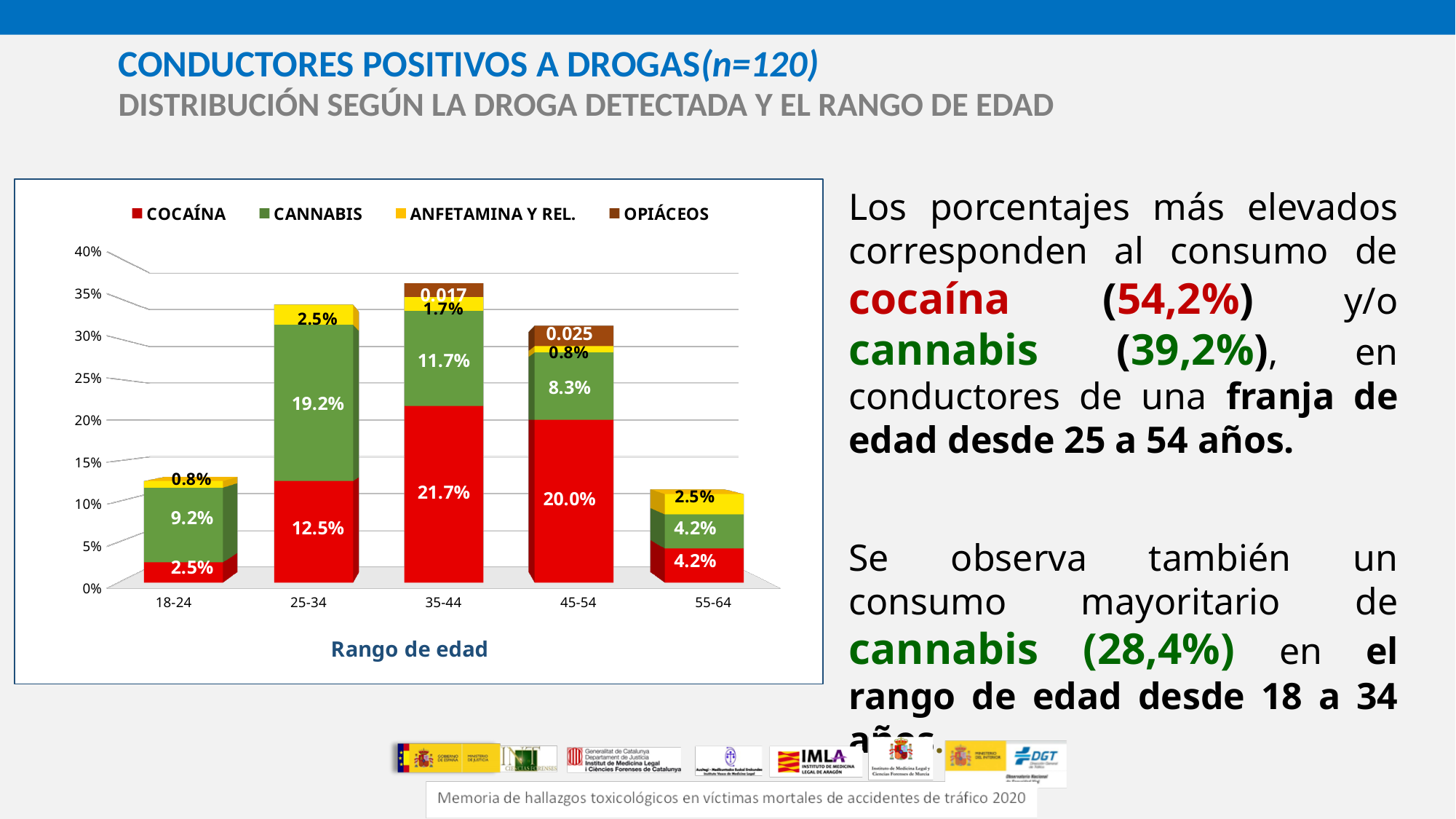
What is the total of the stacked bar for the 18-24 age range? 12.5% What is the difference between the CANNABIS values for 25-34 and 45-54? 10.9% How many series does the legend list? 4 What is the x-axis title of the chart? Rango de edad Which age range has the lowest COCAÍNA value? 18-24 What is the CANNABIS value for the 25-34 age range? 19.2% Which age range has the highest COCAÍNA value? 35-44 What type of chart is shown on the slide? stacked bar chart How many age ranges are shown on the x axis? 5 What is the COCAÍNA value for the 35-44 age range? 21.7% What is the ANFETAMINA Y REL. value for the 55-64 age range? 2.5% Which is larger, the COCAÍNA value for 25-34 or the COCAÍNA value for 45-54? 45-54